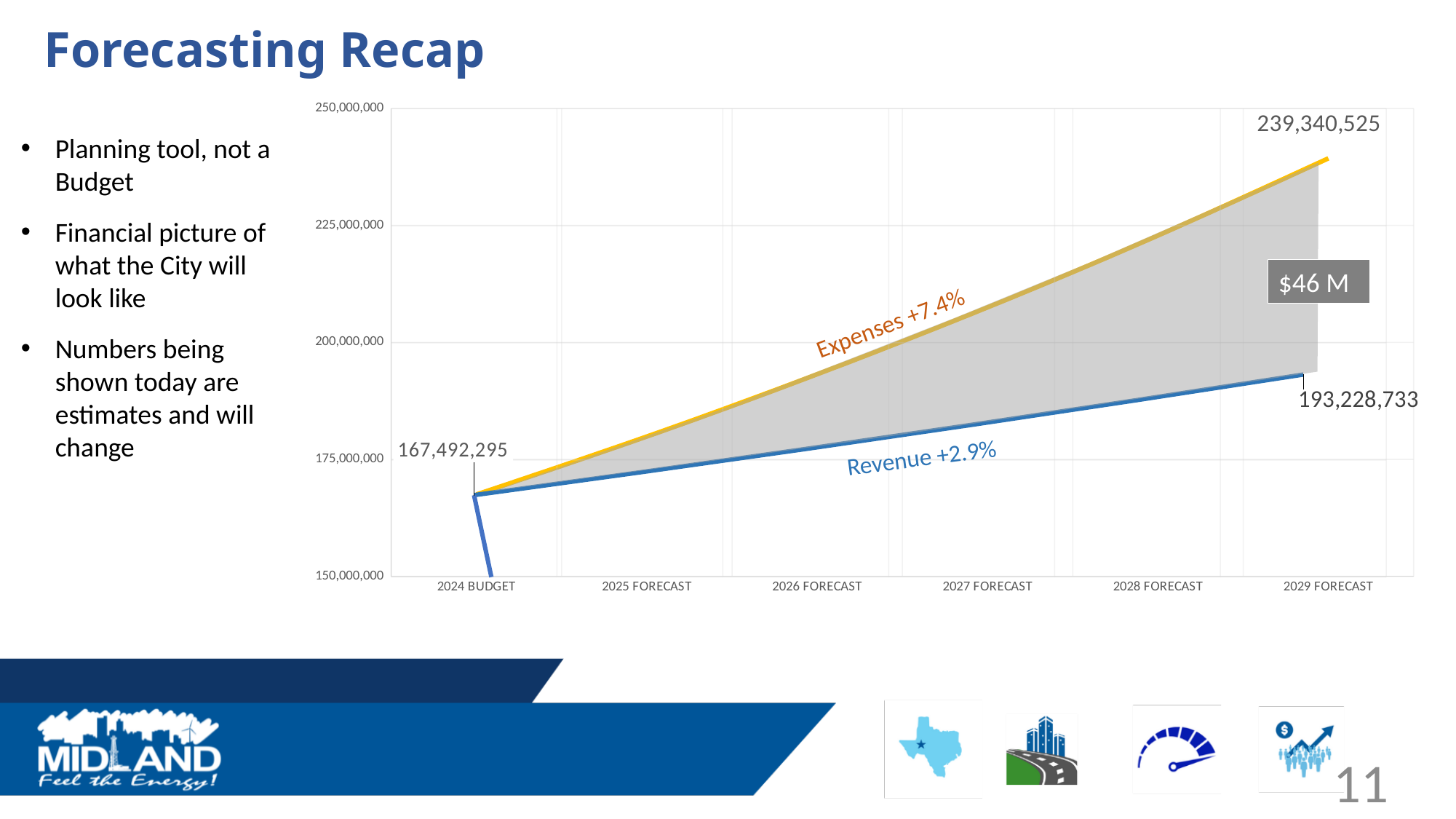
What gap amount is shown in the grey box between the two lines at the 2029 Forecast? $46 M What is the Revenue value shown for the 2029 Forecast? 193,228,733 What is the Expenses value shown for the 2029 Forecast? 239,340,525 Is the Revenue value for the 2027 Forecast greater or less than 200,000,000? less What is the value shown for the 2024 Budget starting point? 167,492,295 What growth rate is labelled on the Revenue line? +2.9% Which is larger at the 2029 Forecast, Expenses or Revenue? Expenses What is the difference between the Expenses and Revenue values at the 2029 Forecast? 46,111,792 What growth rate is labelled on the Expenses line? +7.4% How many periods are shown on the x axis? 6 What kind of chart is shown on the slide? Line chart Is the Expenses value for the 2027 Forecast greater or less than 200,000,000? greater